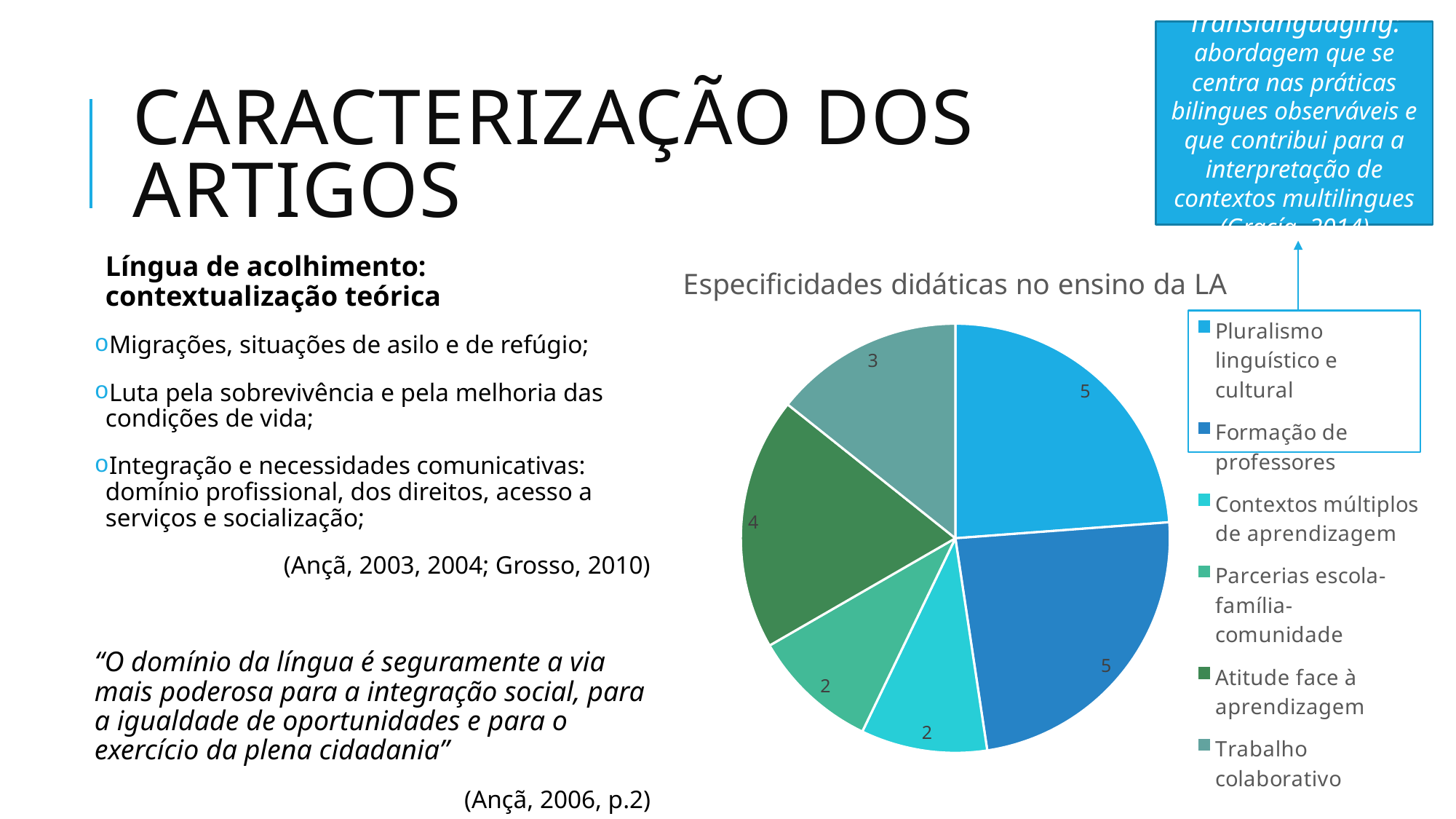
What is the value for Trabalho colaborativo in the pie chart? 3 How many categories does the pie chart's legend list? 6 Which categories have the smallest slices in the pie chart? Contextos múltiplos de aprendizagem and Parcerias escola-família-comunidade What is the value for Pluralismo linguístico e cultural in the pie chart? 5 What is the value for Atitude face à aprendizagem in the pie chart? 4 What is the total of all the values shown in the pie chart? 21 Which categories have the largest slices in the pie chart? Pluralismo linguístico e cultural and Formação de professores Which is larger in the pie chart: Atitude face à aprendizagem or Parcerias escola-família-comunidade? Atitude face à aprendizagem What is the difference between the values for Formação de professores and Trabalho colaborativo? 2 What type of chart is shown on the slide? Pie chart What is the value for Contextos múltiplos de aprendizagem in the pie chart? 2 What is the title of the pie chart? Especificidades didáticas no ensino da LA